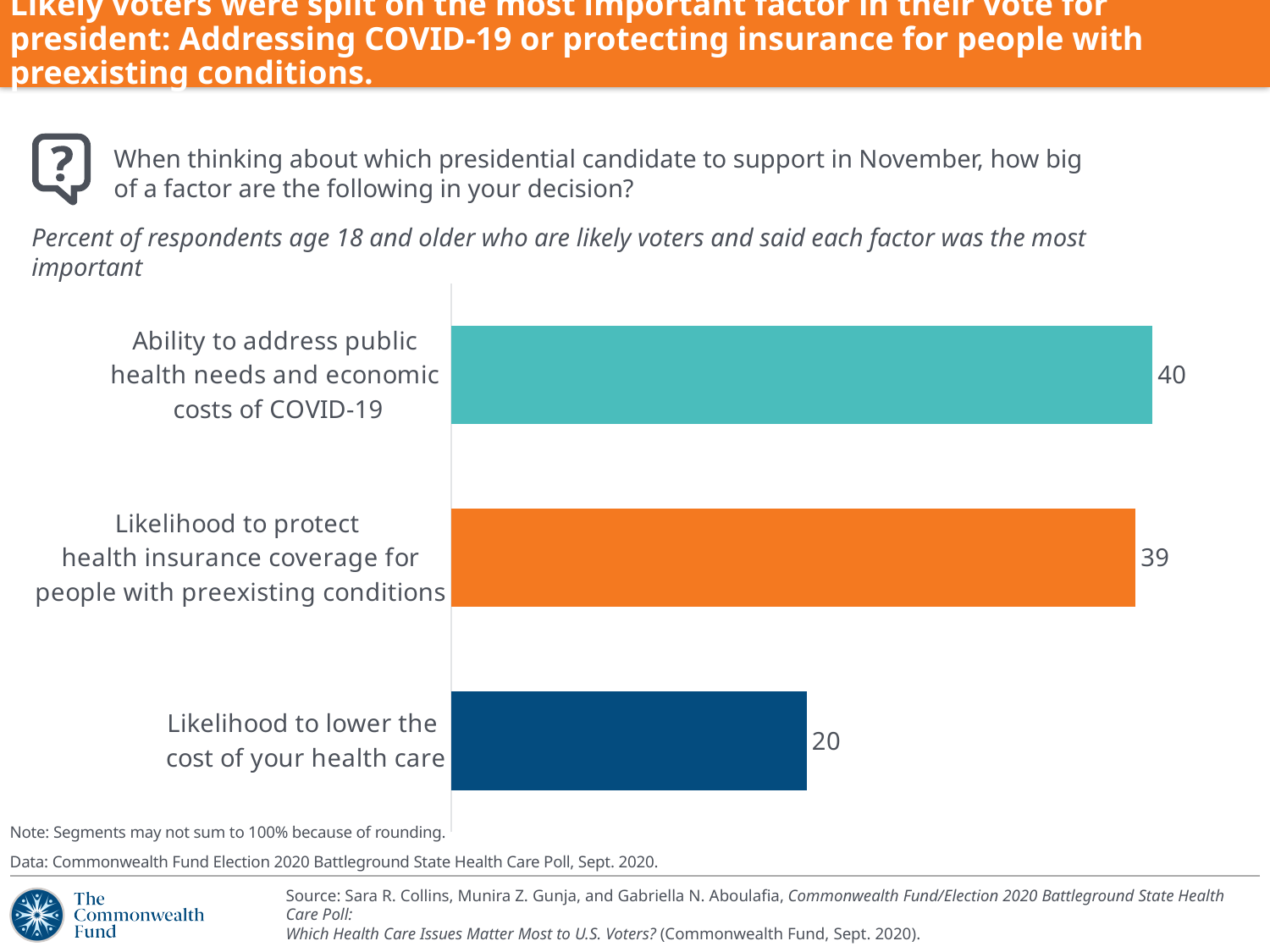
What percent of likely voters said the likelihood to lower the cost of your health care was the most important factor? 20 How many factors (categories) are shown in the chart? 3 What percent of likely voters said the likelihood to protect health insurance coverage for people with preexisting conditions was the most important factor? 39 What is the difference between the value for addressing COVID-19 and the value for lowering the cost of your health care? 20 What kind of chart is shown on the slide? Bar chart Which factor has the lowest value in the chart? Likelihood to lower the cost of your health care Which is larger: the value for protecting coverage for people with preexisting conditions or the value for lowering the cost of your health care? Likelihood to protect health insurance coverage for people with preexisting conditions What colour is the bar for the likelihood to lower the cost of your health care? Dark blue What is the total of the three values shown in the chart? 99 What is the difference between the value for addressing COVID-19 and the value for protecting coverage for people with preexisting conditions? 1 What colour is the bar for the ability to address public health needs and economic costs of COVID-19? Teal What percent of likely voters said the ability to address public health needs and economic costs of COVID-19 was the most important factor? 40